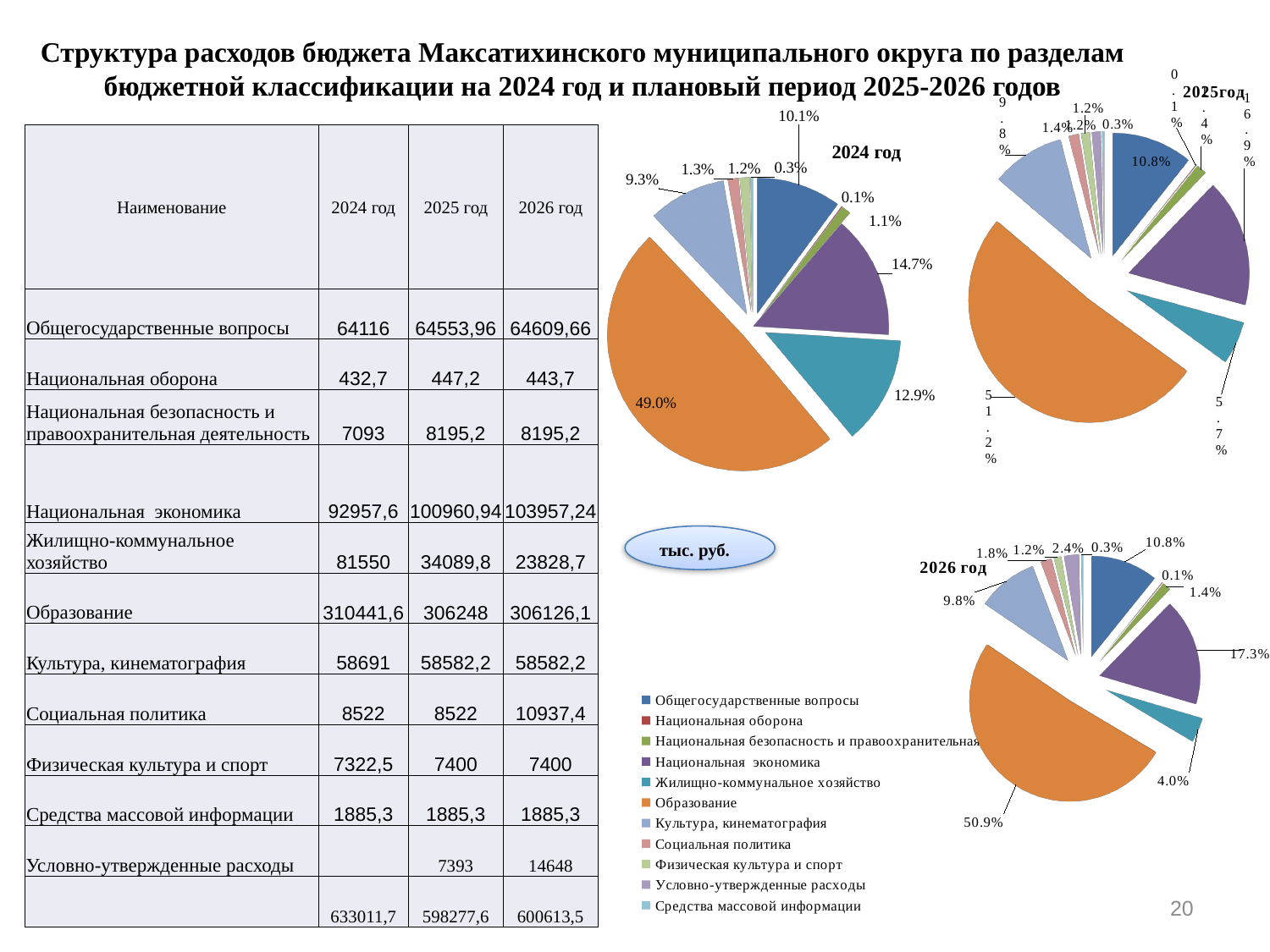
What kind of charts are shown on the slide? Pie charts Which is larger: the share of Жилищно-коммунальное хозяйство on the 2024 год pie chart or on the 2026 год pie chart? 2024 год By how many percentage points does the share of Образование on the 2026 год pie chart exceed its share on the 2024 год pie chart? 1.9 How many categories does the shared legend list? 11 On the 2024 год pie chart, what share is shown for Жилищно-коммунальное хозяйство? 12.9% On the 2024 год pie chart, which category has the largest slice? Образование On the 2026 год pie chart, what share is shown for Жилищно-коммунальное хозяйство? 4.0% On the 2026 год pie chart, what share is shown for Образование? 50.9%